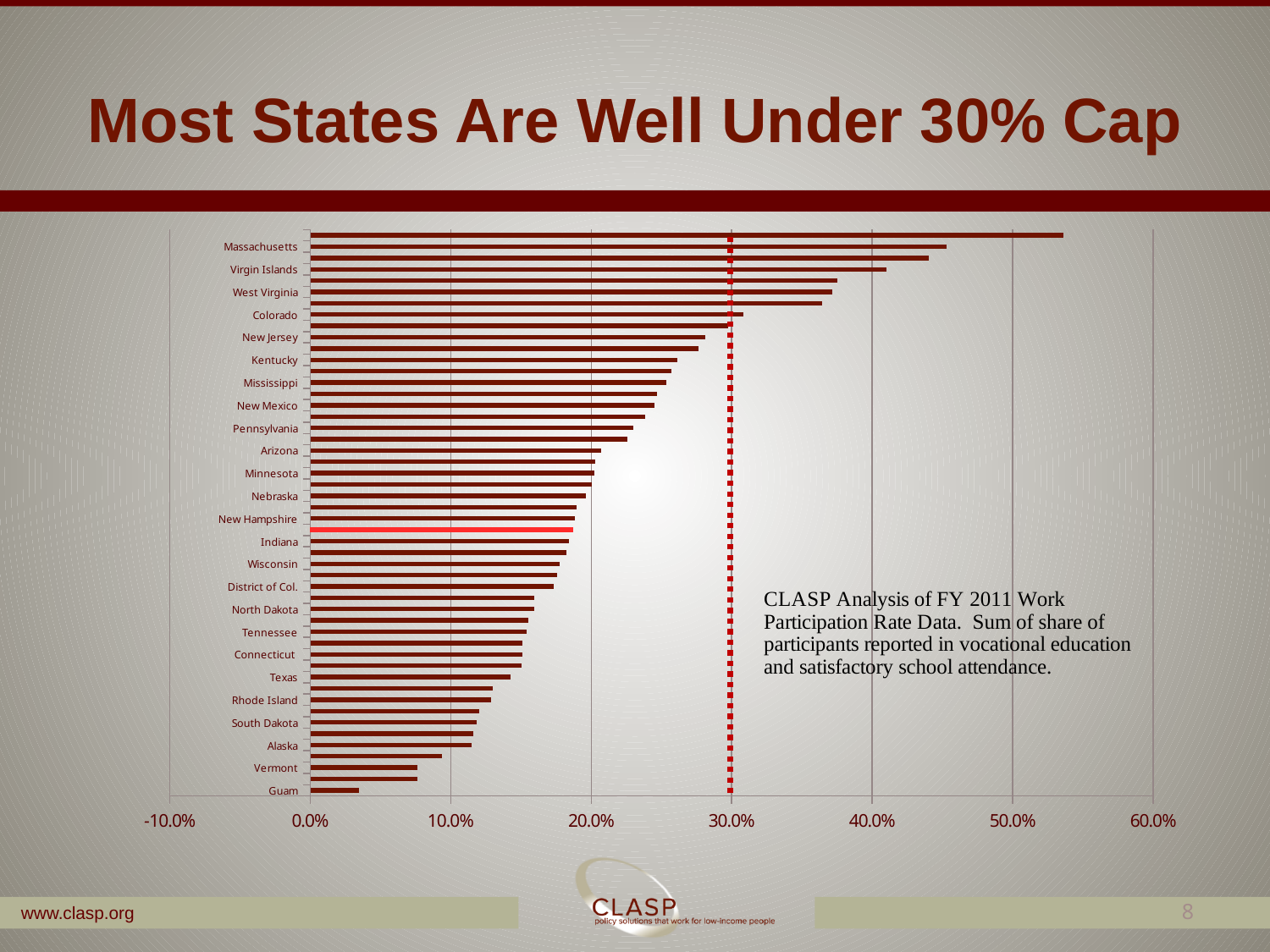
Is the value for Guam greater or less than 10.0%? less Is the value for Kentucky greater or less than 30.0%? less Is the value for West Virginia greater or less than 30.0%? greater What kind of chart is shown on the slide? bar chart Do the bar values rise or fall going from the top of the chart to the bottom? fall At what value on the x axis is the red dashed vertical line drawn? 30.0% Which is larger, the value for Virgin Islands or the value for Vermont? Virgin Islands What is the title of the slide containing the chart? Most States Are Well Under 30% Cap